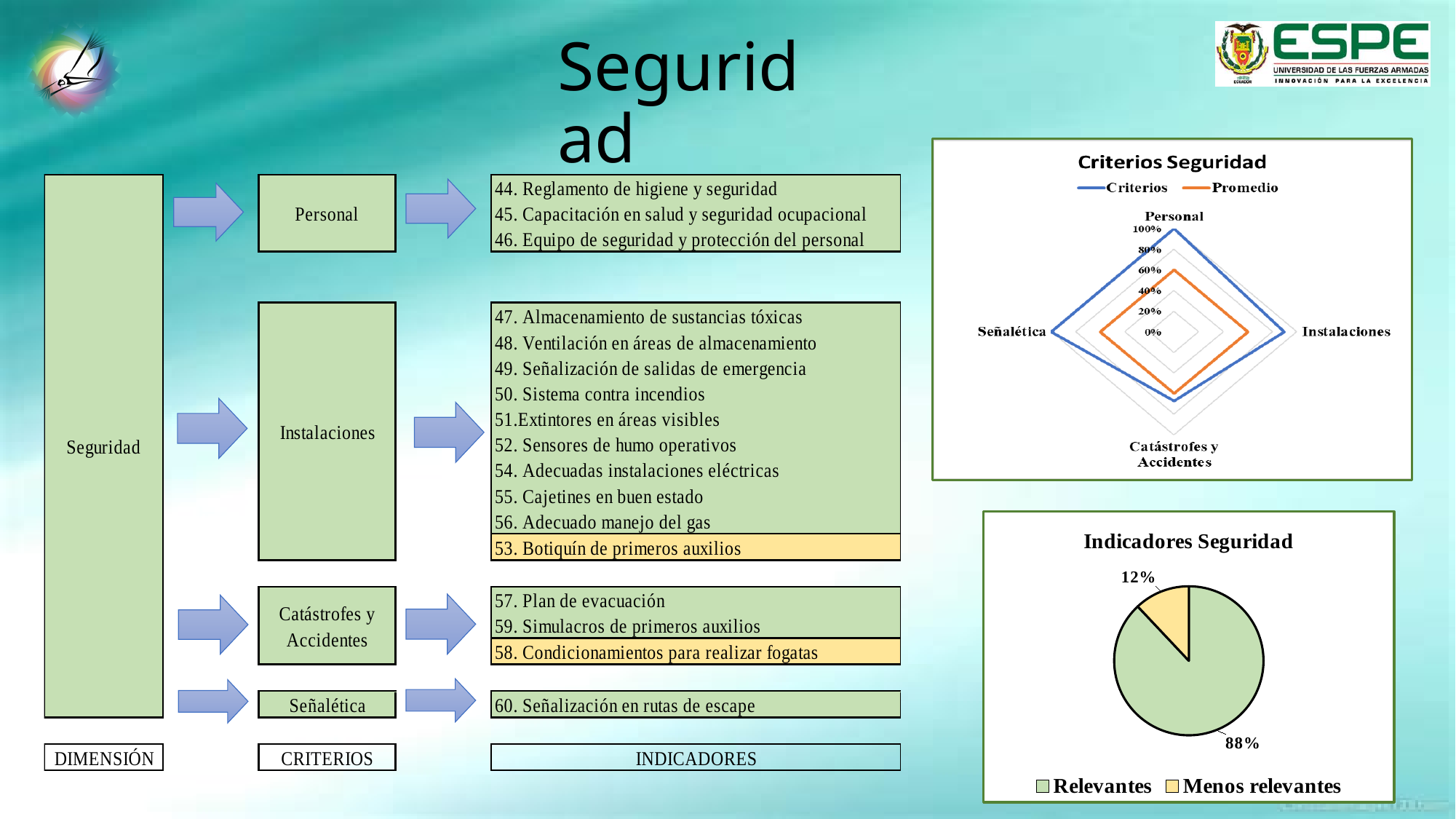
How many series does the legend of the 'Criterios Seguridad' chart list? 2 In the 'Indicadores Seguridad' chart, which slice is the largest? Relevantes In the 'Indicadores Seguridad' chart, what share does 'Menos relevantes' have? 12% What kind of chart is the 'Indicadores Seguridad' chart? pie chart What kind of chart is the 'Criterios Seguridad' chart? radar chart In the 'Criterios Seguridad' chart, is the 'Promedio' value for Personal greater or less than 80%? less In the 'Criterios Seguridad' chart, which series has the larger value for Señalética, 'Criterios' or 'Promedio'? Criterios In the 'Indicadores Seguridad' chart, what is the difference between the 'Relevantes' and 'Menos relevantes' shares? 76% In the 'Criterios Seguridad' chart, is the 'Criterios' value for Instalaciones greater or less than 80%? greater How many slices does the 'Indicadores Seguridad' pie chart have? 2 How many categories (axes) does the 'Criterios Seguridad' radar chart have? 4 In the 'Indicadores Seguridad' chart, what share does 'Relevantes' have? 88%